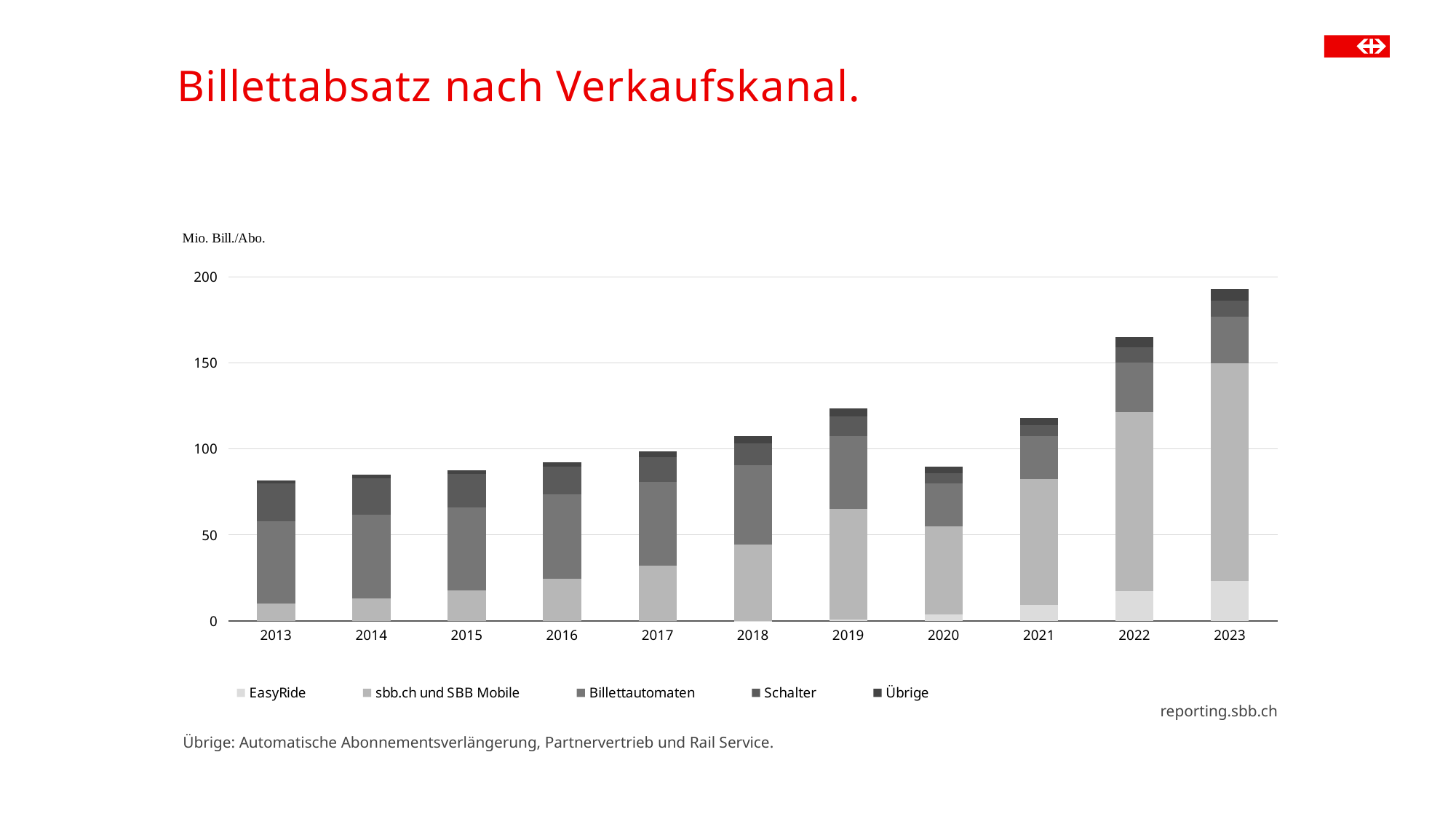
What is the title of the chart on the slide? Billettabsatz nach Verkaufskanal. Which year has the highest total bar in the chart? 2023 Is the total value for 2020 greater or less than 100? less How many years are shown on the x axis of the chart? 11 What unit label is shown above the y axis of the chart? Mio. Bill./Abo. Is the total value for 2023 greater or less than 150? greater What kind of chart is shown on the slide? Stacked bar chart How many series does the chart's legend list? 5 Is the total value for 2019 greater or less than 100? greater Do the total bar values rise or fall from 2013 to 2019? rise Which year has the lowest total bar in the chart? 2013 Which year has the larger total bar, 2021 or 2022? 2022